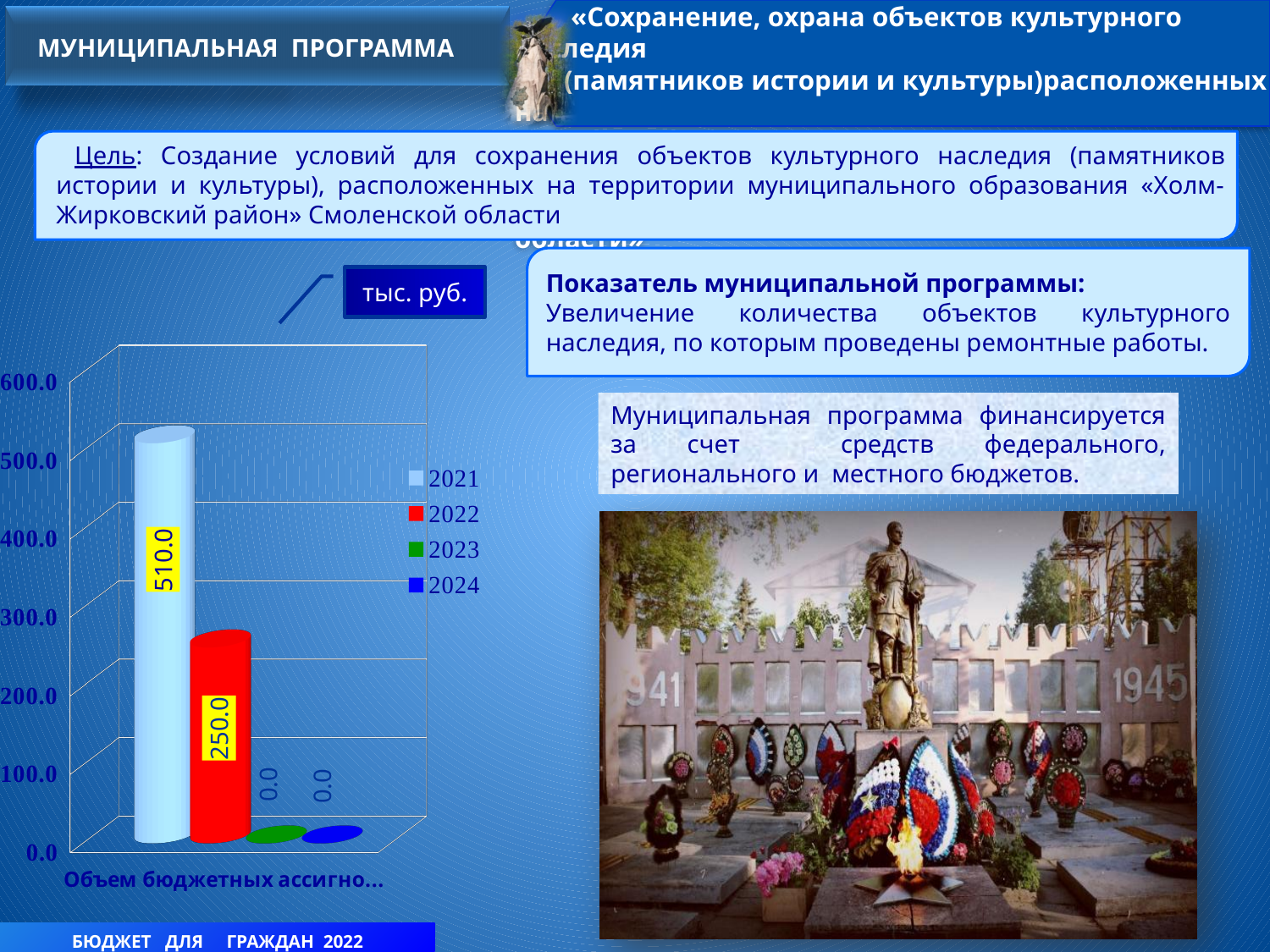
What is the value for 2022 in the chart? 250.0 Which year has the highest value in the chart? 2021 What is the value for 2024 in the chart? 0.0 What is the difference between the values for 2021 and 2022? 260.0 What type of chart is shown on the slide? bar chart What unit of measurement is indicated for the chart values? тыс. руб. What colour is the bar for 2022 in the chart? red Is the value for 2022 greater or less than 300.0? less What is the value for 2021 in the chart? 510.0 What is the value for 2023 in the chart? 0.0 How many series does the chart legend list? 4 Which is larger, the value for 2021 or the value for 2022? 2021